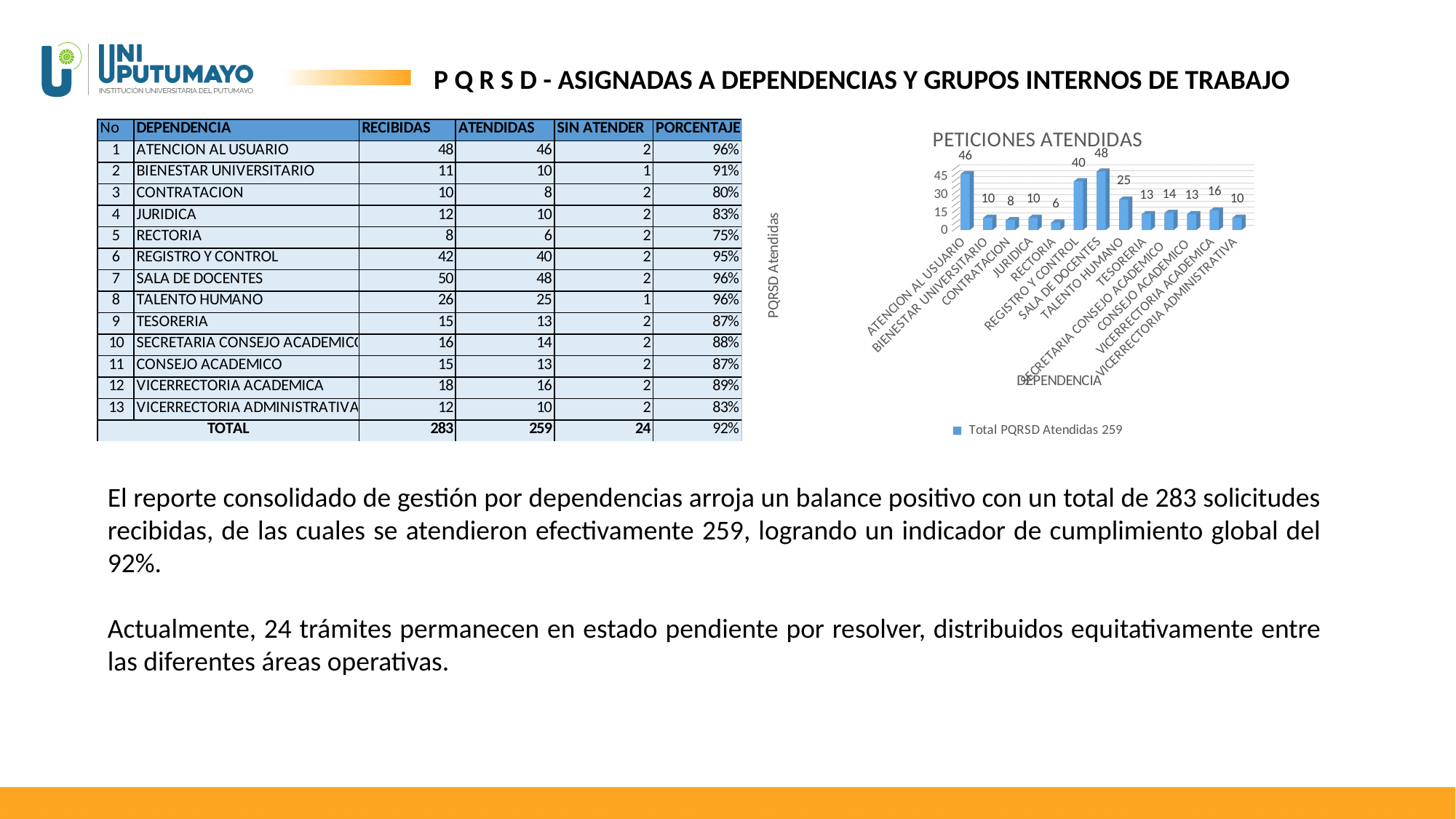
Which dependencia has the lowest value in the chart? RECTORIA How many dependencias (categories) are plotted in the chart? 13 Which has a larger value in the chart, VICERRECTORIA ACADEMICA or TESORERIA? VICERRECTORIA ACADEMICA How many series does the chart legend list? 1 What type of chart is shown on the slide? bar chart Which dependencia has the highest value in the chart? SALA DE DOCENTES What is the difference between the values for ATENCION AL USUARIO and REGISTRO Y CONTROL? 6 What is the value for TALENTO HUMANO in the chart? 25 What is the value for SALA DE DOCENTES in the chart? 48 What is the value for RECTORIA in the chart? 6 What is the legend entry shown below the chart? Total PQRSD Atendidas 259 What is the title of the chart? PETICIONES ATENDIDAS